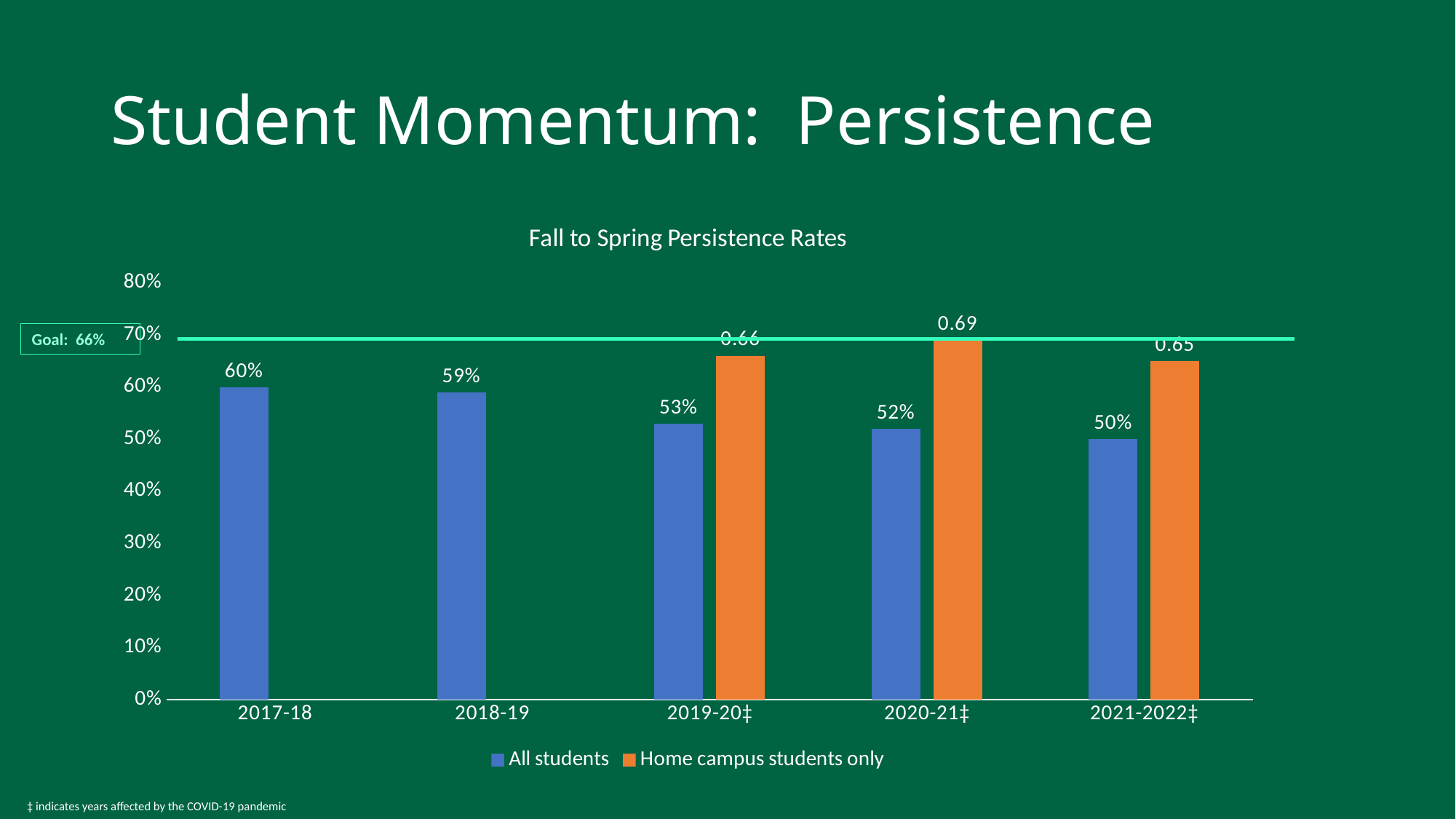
What goal value is marked by the horizontal line on the chart? 66% How many year categories are shown on the x axis? 5 Which year has the lowest value for All students? 2021-2022‡ What is the Fall to Spring persistence rate for All students in 2017-18? 60% How many series does the legend list? 2 What is the difference between the All students values for 2017-18 and 2021-2022‡? 10 percentage points What is the value for Home campus students only in 2020-21‡? 0.69 Do the All students values rise or fall from 2017-18 to 2021-2022‡? Fall What is the value for All students in 2021-2022‡? 50% Which is larger in 2019-20‡: the All students value or the Home campus students only value? Home campus students only What kind of chart is shown on the slide? Bar chart Which year has the highest value for All students? 2017-18